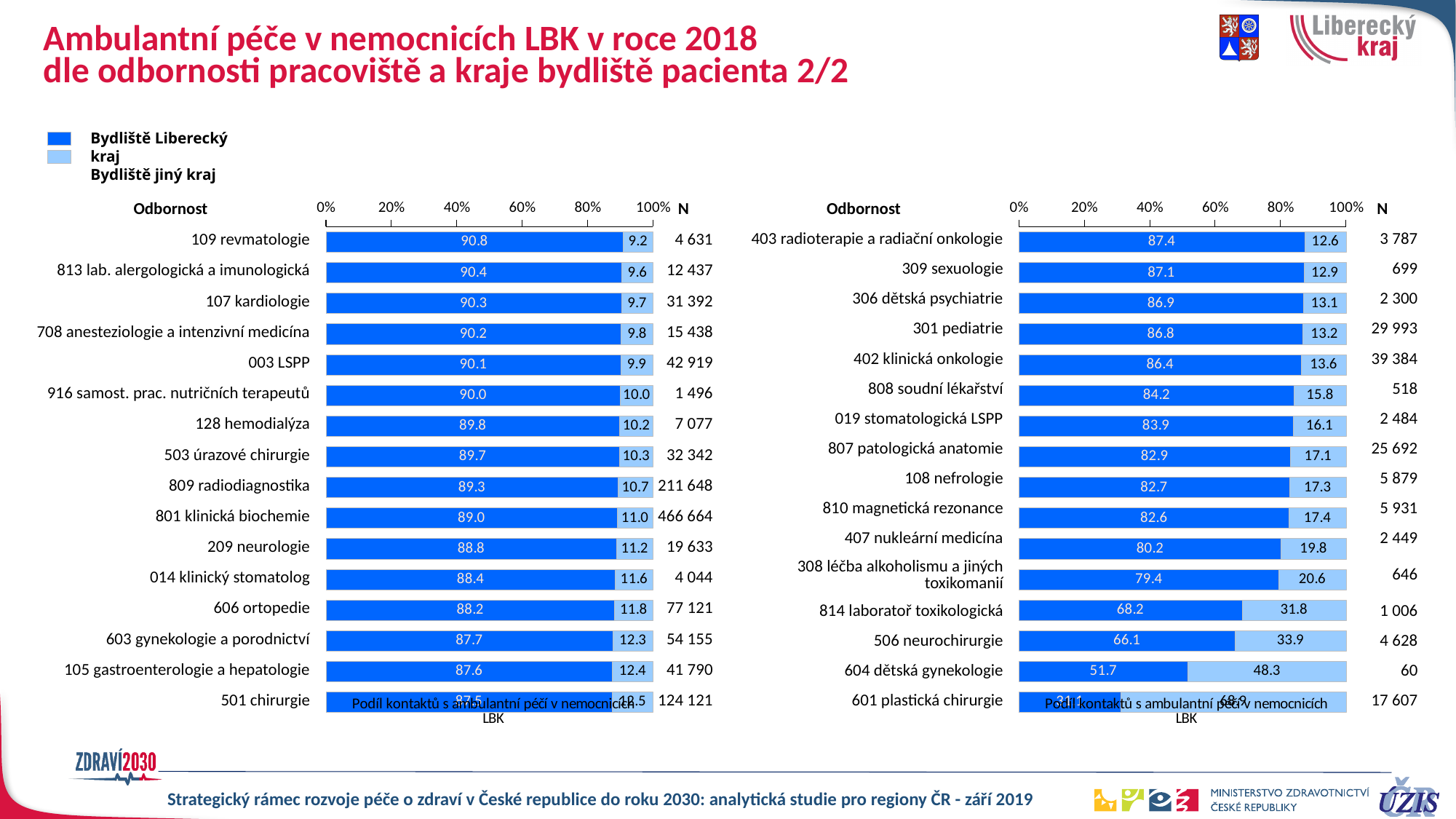
In the right chart, what is the value for Bydliště jiný kraj for 604 dětská gynekologie? 48.3 In the left chart, what is the value for Bydliště Liberecký kraj for 109 revmatologie? 90.8 In the right chart, is the Bydliště Liberecký kraj value for 604 dětská gynekologie greater or less than 60%? less How many series does the legend list? 2 In the left chart, what is the difference between the Bydliště Liberecký kraj values for 107 kardiologie and 606 ortopedie? 2.1 In the left chart, which category has the highest Bydliště Liberecký kraj share? 109 revmatologie In the right chart, which category has the lowest Bydliště Liberecký kraj share? 601 plastická chirurgie In the left chart, what is the N value shown for 801 klinická biochemie? 466 664 How many categories (odbornosti) are plotted in the left chart? 16 In the right chart, which has the larger Bydliště jiný kraj value: 506 neurochirurgie or 814 laboratoř toxikologická? 506 neurochirurgie What kind of chart is the left chart? bar chart In the right chart, what is the value for Bydliště jiný kraj for 301 pediatrie? 13.2